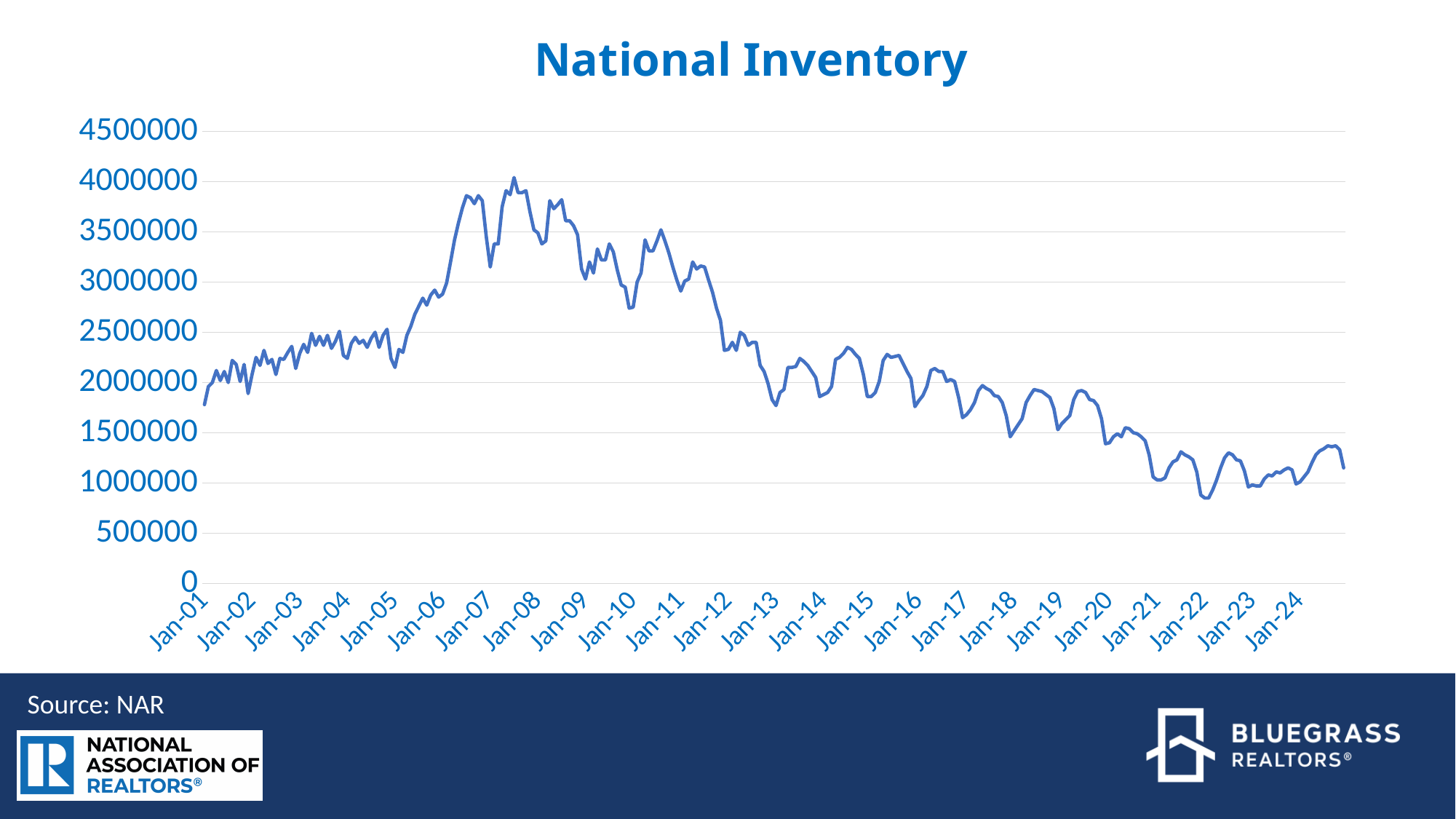
Does the line generally rise or fall between Jan-08 and Jan-22? Fall Is the value at Jan-06 greater or less than 2500000? greater Is the value at Jan-22 greater or less than 1000000? less Is the value at Jan-01 greater or less than 2000000? less Near which x-axis label does the line reach its lowest point? Jan-22 What is the title of the chart? National Inventory What source is cited for the chart data? NAR Which is larger, the value at Jan-08 or the value at Jan-22? Jan-08 How many year labels are shown on the x axis? 24 What type of chart is shown on the slide? Line chart